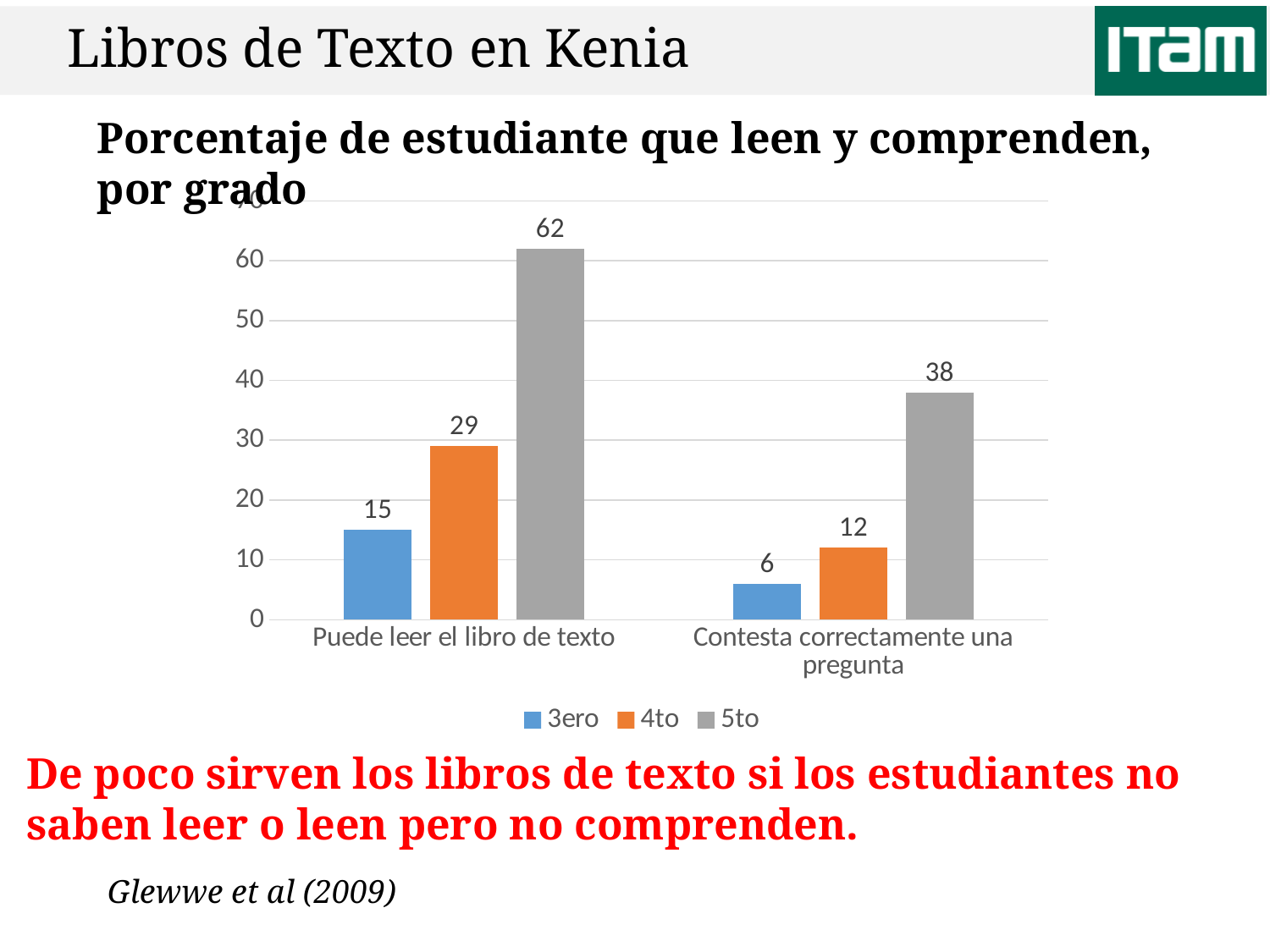
Which is larger: the 4to value for 'Puede leer el libro de texto' or the 5to value for 'Contesta correctamente una pregunta'? 5to value for 'Contesta correctamente una pregunta' How many categories are shown on the x axis? 2 What kind of chart is shown on the slide? Bar chart What is the difference between the 5to values for 'Puede leer el libro de texto' and 'Contesta correctamente una pregunta'? 24 What is the value for 4to in the 'Puede leer el libro de texto' category? 29 What is the value for 3ero in the 'Contesta correctamente una pregunta' category? 6 What colour represents the 4to series in the chart? Orange Which series has the lowest value in the 'Puede leer el libro de texto' category? 3ero What is the difference between the 4to and 3ero values in the 'Contesta correctamente una pregunta' category? 6 What is the value for 5to in the 'Puede leer el libro de texto' category? 62 How many series does the legend list? 3 Which series has the highest value in the 'Contesta correctamente una pregunta' category? 5to